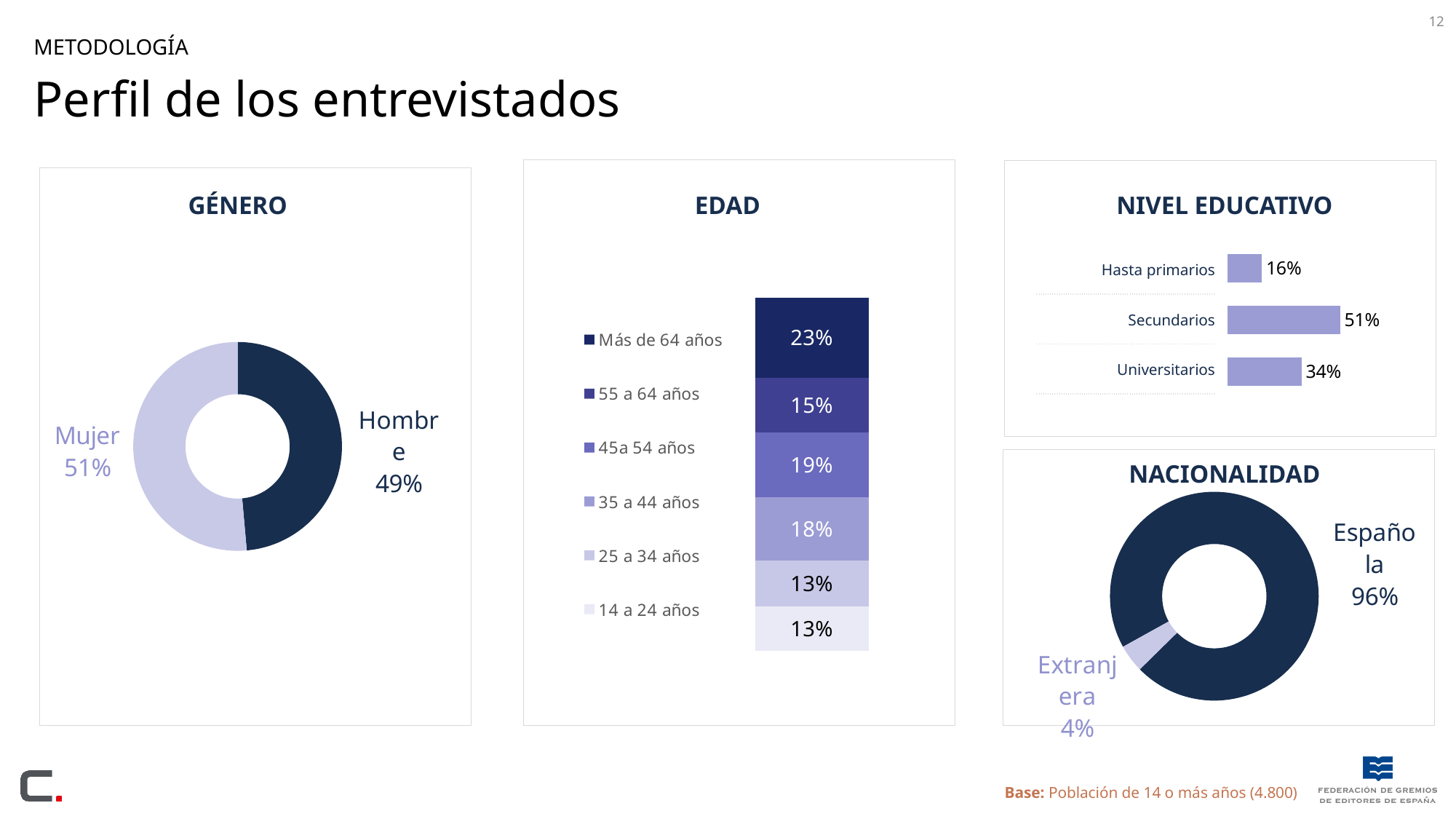
In the NIVEL EDUCATIVO chart, which category has the lowest percentage? Hasta primarios In the NACIONALIDAD chart, what percentage is shown for Extranjera? 4% In the EDAD chart, what percentage is shown for Más de 64 años? 23% In the GÉNERO chart, what percentage is shown for Mujer? 51% In the NIVEL EDUCATIVO chart, what percentage is shown for Secundarios? 51% In the EDAD chart, what is the difference between the 45a 54 años and 55 a 64 años percentages? 4% In the NACIONALIDAD chart, what is the difference between Española and Extranjera? 92% In the GÉNERO chart, which segment is larger, Mujer or Hombre? Mujer How many age groups does the legend of the EDAD chart list? 6 In the EDAD chart, which age group has the highest percentage? Más de 64 años What kind of chart is the GÉNERO chart? Donut (pie) chart How many categories are shown in the NIVEL EDUCATIVO chart? 3